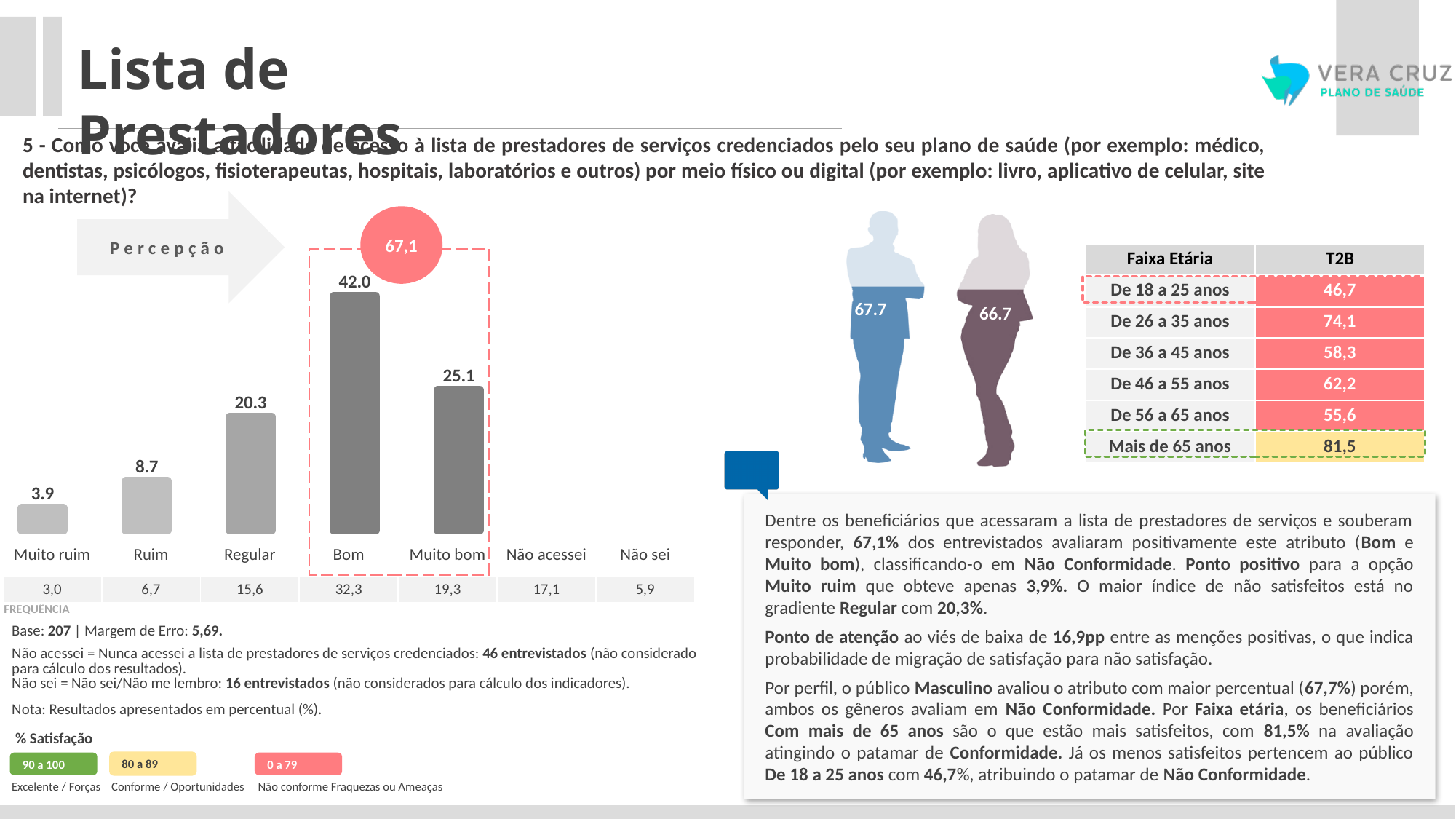
In the bar chart, which category has the highest value? Bom In the bar chart, what is the difference between the values for Bom and Muito bom? 16.9 In the bar chart, which category has the lowest plotted value? Muito ruim What kind of chart is shown on the left of the slide? Bar chart In the bar chart, what is the value for Bom? 42.0 In the Faixa Etária table, what is the T2B value for Mais de 65 anos? 81,5 In the bar chart, what is the value for Regular? 20.3 In the bar chart, what value is shown in the red circle above the Bom and Muito bom bars? 67,1 How many bars are plotted in the bar chart? 5 In the bar chart, what is the value for Muito ruim? 3.9 In the Faixa Etária table, which age group has the lowest T2B value? De 18 a 25 anos In the bar chart, which is larger, the value for Ruim or the value for Regular? Regular